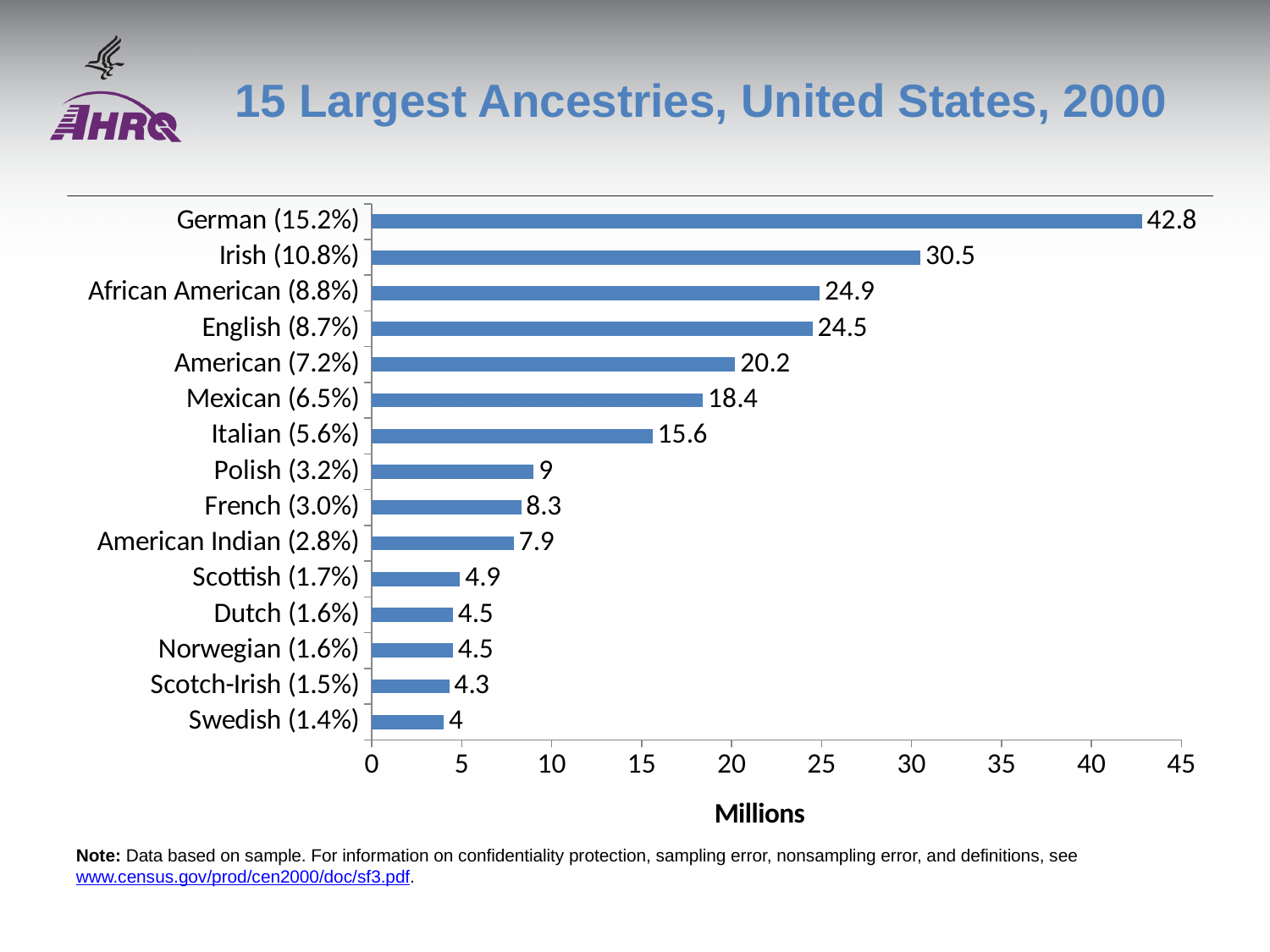
What is the value for Polish (3.2%)? 9 What is the difference between the values for German (15.2%) and Irish (10.8%)? 12.3 Which ancestry has the highest value? German (15.2%) What kind of chart is shown on the slide? bar chart Is the value for Irish (10.8%) greater or less than 30? greater What is the value for German (15.2%)? 42.8 Which is larger, the value for American (7.2%) or the value for English (8.7%)? English (8.7%) What is the value for Mexican (6.5%)? 18.4 Which ancestry has the lowest value? Swedish (1.4%) What is the difference between the values for Italian (5.6%) and French (3.0%)? 7.3 How many ancestry categories are shown in the chart? 15 What is the label on the horizontal axis of the chart? Millions